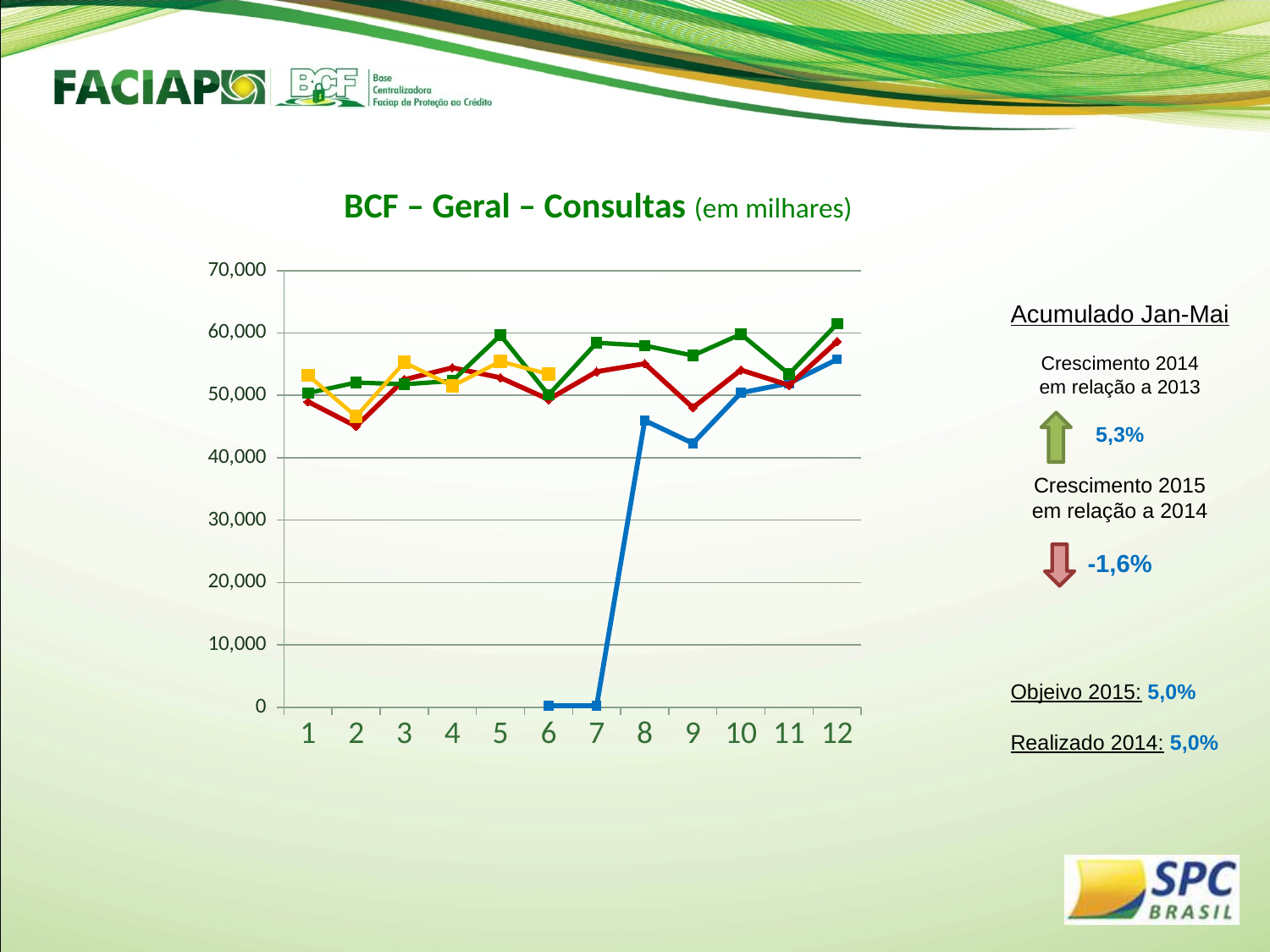
Is the value of the green line at point 12 greater or less than 50,000? greater Is the value of the blue line at point 8 greater or less than 40,000? greater How many points are on the x axis of the chart? 12 Is the value of the blue line at point 6 greater or less than 10,000? less How many lines are plotted on the chart? 4 What kind of chart is shown on the slide? line chart At which x-axis point does the green line reach its highest value? 12 At point 9, which line has the larger value, the red line or the blue line? red line What is the highest value shown on the y axis of the chart? 70,000 At which x-axis point does the red line reach its lowest value? 2 What is the title of the chart? BCF – Geral – Consultas (em milhares)